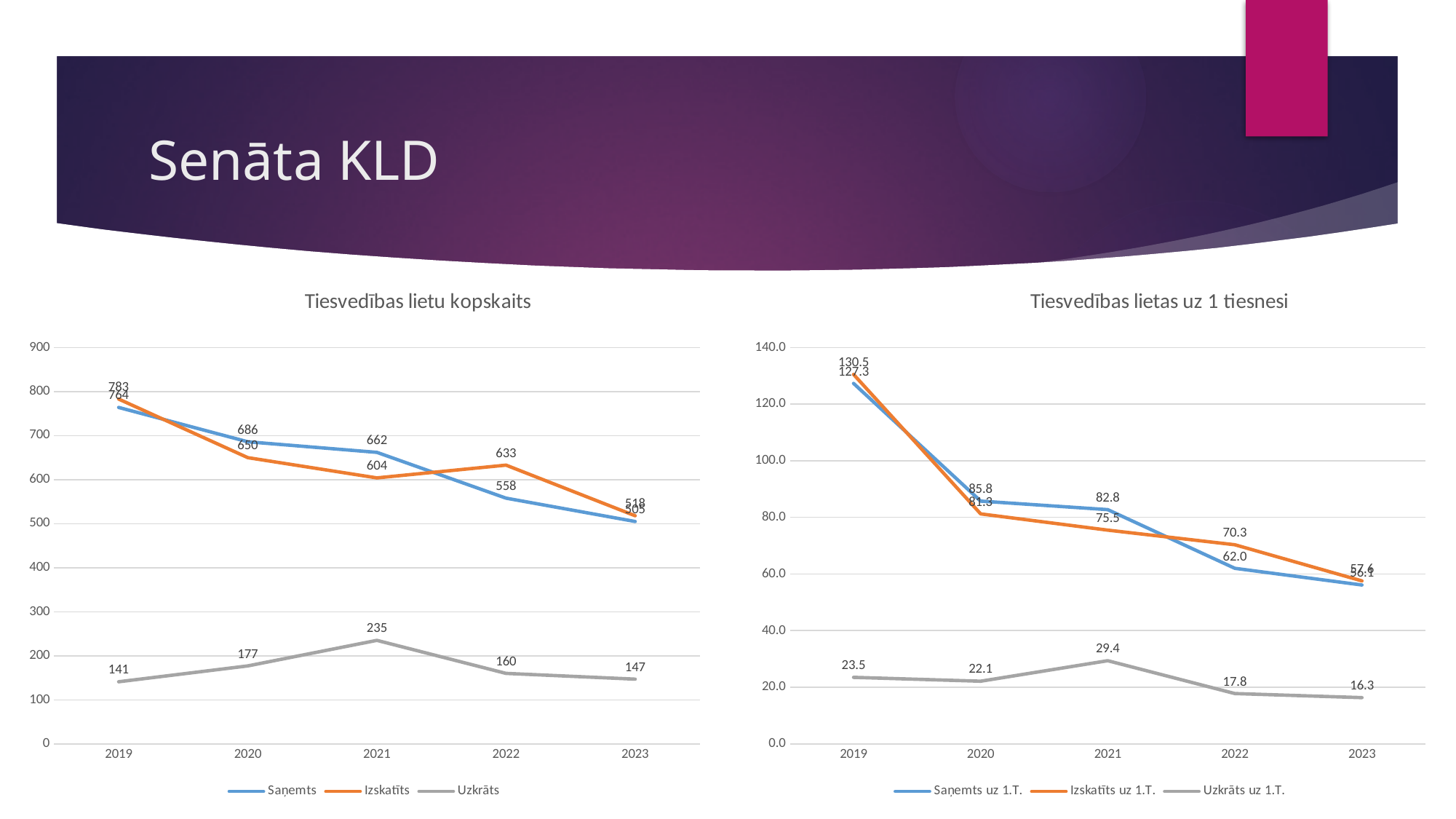
How many years are shown on the x axis of the chart titled "Tiesvedības lietas uz 1 tiesnesi"? 5 In the chart titled "Tiesvedības lietu kopskaits", in which year is Uzkrāts highest? 2021 In the chart titled "Tiesvedības lietas uz 1 tiesnesi", does Saņemts uz 1.T. rise or fall from 2019 to 2023? Fall In the chart titled "Tiesvedības lietas uz 1 tiesnesi", in which year is Uzkrāts uz 1.T. lowest? 2023 In the chart titled "Tiesvedības lietu kopskaits", which is larger in 2022, Saņemts or Izskatīts? Izskatīts In the chart titled "Tiesvedības lietas uz 1 tiesnesi", what is the value for Uzkrāts uz 1.T. in 2021? 29.4 In the chart titled "Tiesvedības lietu kopskaits", what is the value for Izskatīts in 2022? 633 In the chart titled "Tiesvedības lietu kopskaits", what is the difference between Saņemts and Izskatīts in 2021? 58 What kind of chart is "Tiesvedības lietu kopskaits"? Line chart In the chart titled "Tiesvedības lietu kopskaits", what is the value for Saņemts in 2020? 686 In the chart titled "Tiesvedības lietu kopskaits", how many series does the legend list? 3 In the chart titled "Tiesvedības lietas uz 1 tiesnesi", what is the value for Izskatīts uz 1.T. in 2022? 70.3